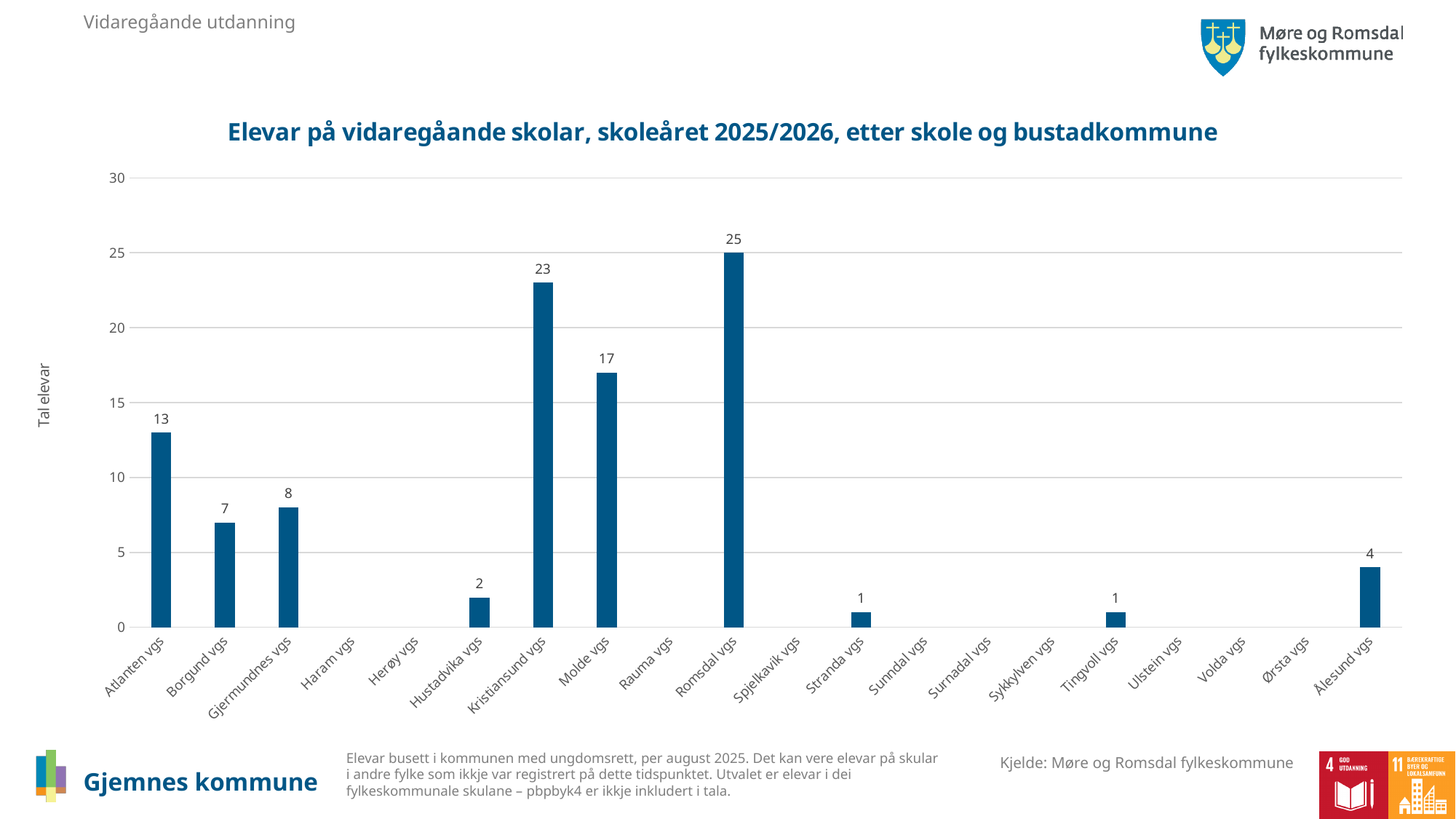
How many students are shown for Atlanten vgs? 13 Which school has the highest number of students? Romsdal vgs What is the value for Ålesund vgs? 4 What kind of chart is shown on the slide? Bar chart What is the title of the chart? Elevar på vidaregåande skolar, skoleåret 2025/2026, etter skole og bustadkommune What is the difference between the values for Romsdal vgs and Kristiansund vgs? 2 How many school categories are listed on the x axis? 20 How many students are shown for Romsdal vgs? 25 What is the label of the y axis? Tal elevar What is the value for Kristiansund vgs? 23 Which has a larger value, Borgund vgs or Gjermundnes vgs? Gjermundnes vgs What is the difference between the values for Molde vgs and Gjermundnes vgs? 9